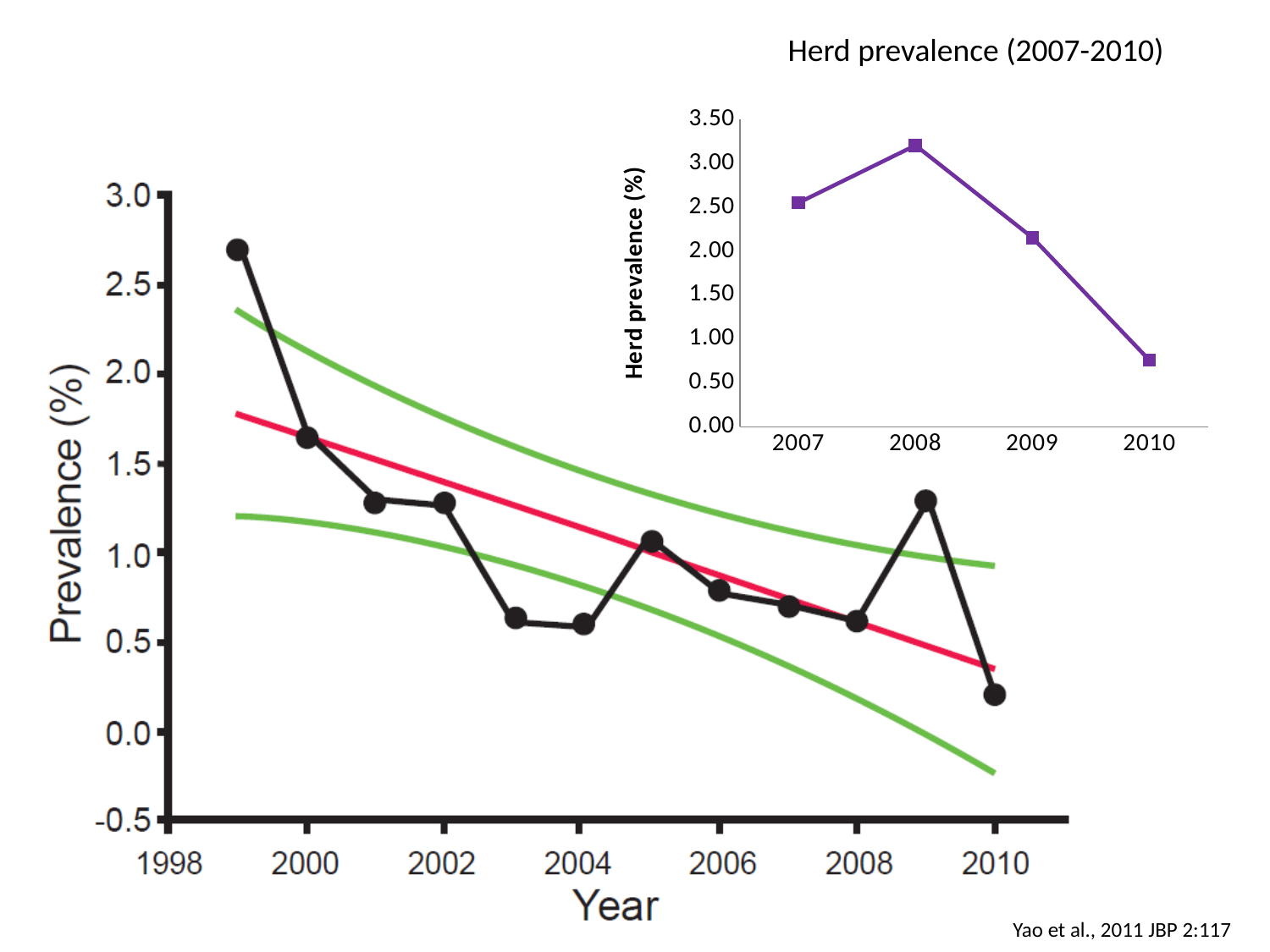
In the large chart on the left (Prevalence (%) vs Year), is the plotted value for 1999 greater or less than 2.5? greater In the large chart on the left (Prevalence (%) vs Year), which year has the highest plotted prevalence? 1999 In the chart titled 'Herd prevalence (2007-2010)', how many years are plotted? 4 In the chart titled 'Herd prevalence (2007-2010)', is the value for 2008 greater or less than 3.00? greater In the large chart on the left (Prevalence (%) vs Year), is the plotted value for 2010 greater or less than 0.5? less In the chart titled 'Herd prevalence (2007-2010)', which year has the lowest herd prevalence? 2010 In the large chart on the left (Prevalence (%) vs Year), does the red trend line rise or fall from 1999 to 2010? fall In the chart titled 'Herd prevalence (2007-2010)', what kind of chart is shown? line chart In the large chart on the left (Prevalence (%) vs Year), which year has the larger plotted prevalence, 2008 or 2009? 2009 In the large chart on the left (Prevalence (%) vs Year), which year has the lowest plotted prevalence? 2010 In the chart titled 'Herd prevalence (2007-2010)', which year has the highest herd prevalence? 2008